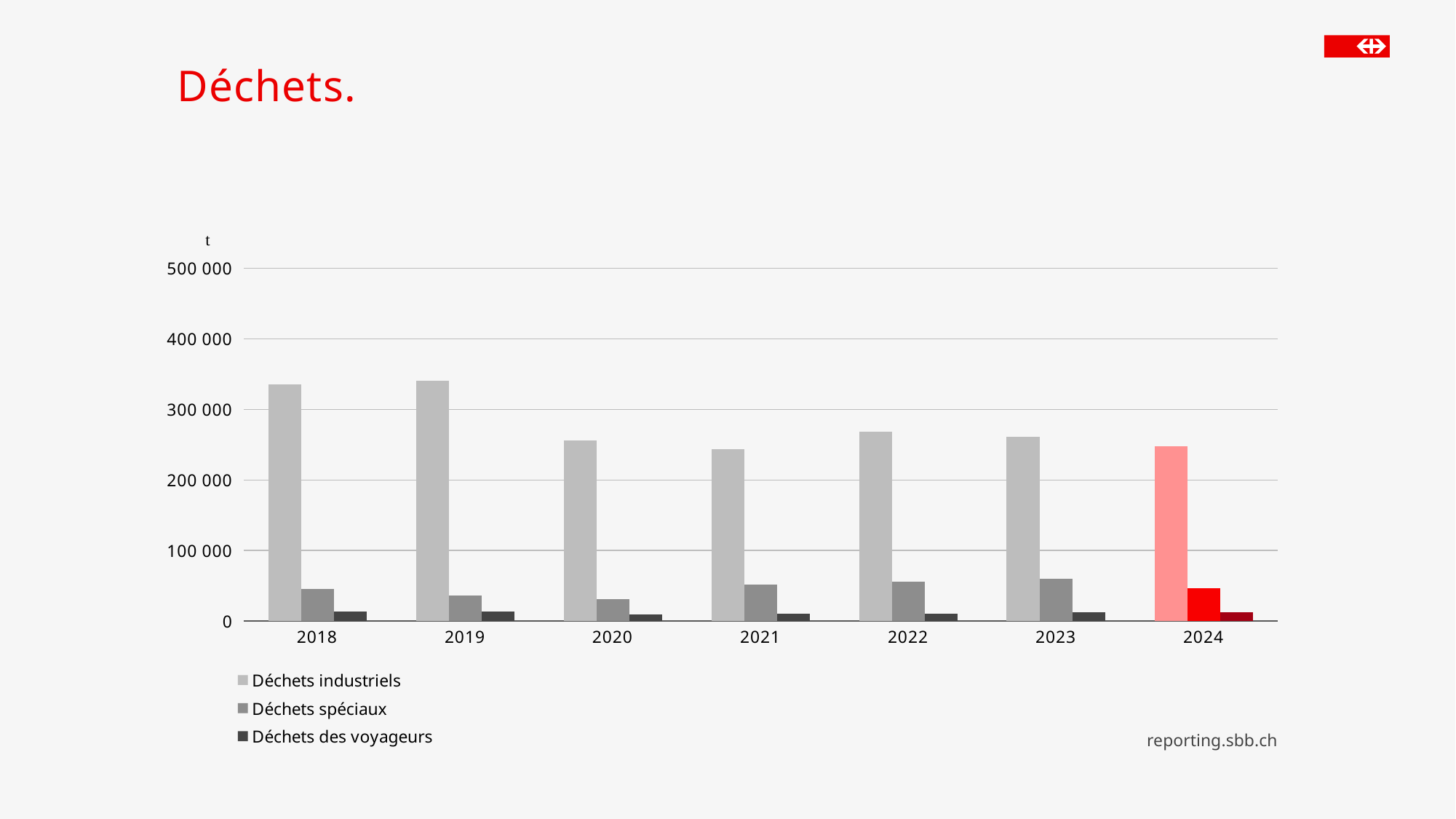
Which is larger, Déchets industriels in 2019 or Déchets industriels in 2020? 2019 Is the value for Déchets spéciaux in 2023 greater or less than 100 000? less Does Déchets industriels overall rise or fall from 2018 to 2024? fall Is the value for Déchets industriels in 2020 greater or less than 300 000? less Which is larger, Déchets spéciaux in 2022 or Déchets spéciaux in 2020? 2022 How many years are shown on the x axis? 7 What kind of chart is shown on the slide? bar chart In which year is Déchets spéciaux lowest? 2020 Is the value for Déchets industriels in 2024 greater or less than 200 000? greater How many series does the legend list? 3 What is the title of the slide? Déchets.